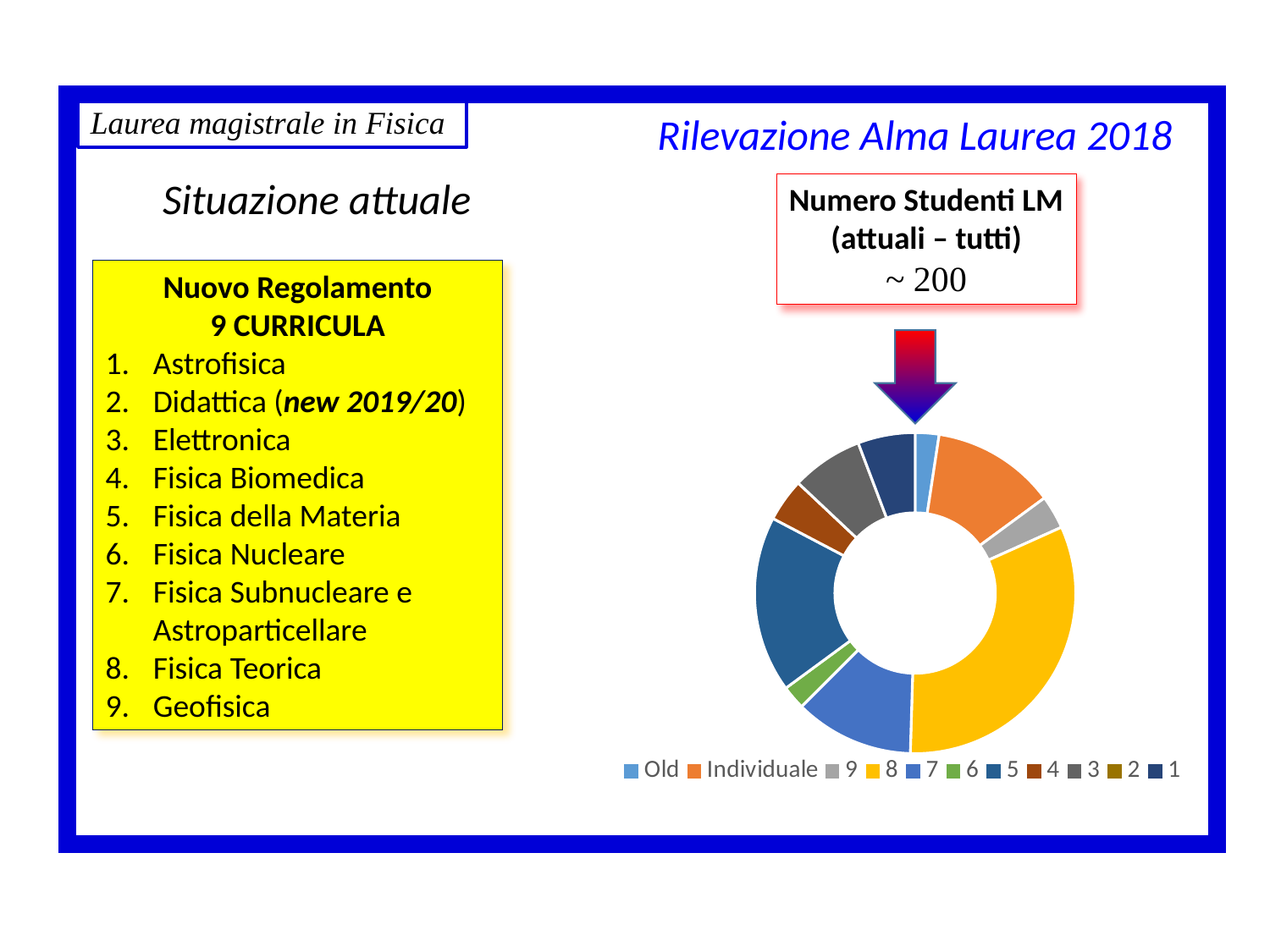
Which slice is larger in the doughnut chart, Individuale or 9? Individuale Which slice is larger in the doughnut chart, 5 or 4? 5 What is the first entry listed in the legend of the doughnut chart? Old How many entries does the legend of the doughnut chart list? 11 Which slice is larger in the doughnut chart, 8 or 5? 8 What colour is the largest slice of the doughnut chart? yellow What kind of chart is shown on the slide? doughnut chart Which category has the largest slice in the doughnut chart? 8